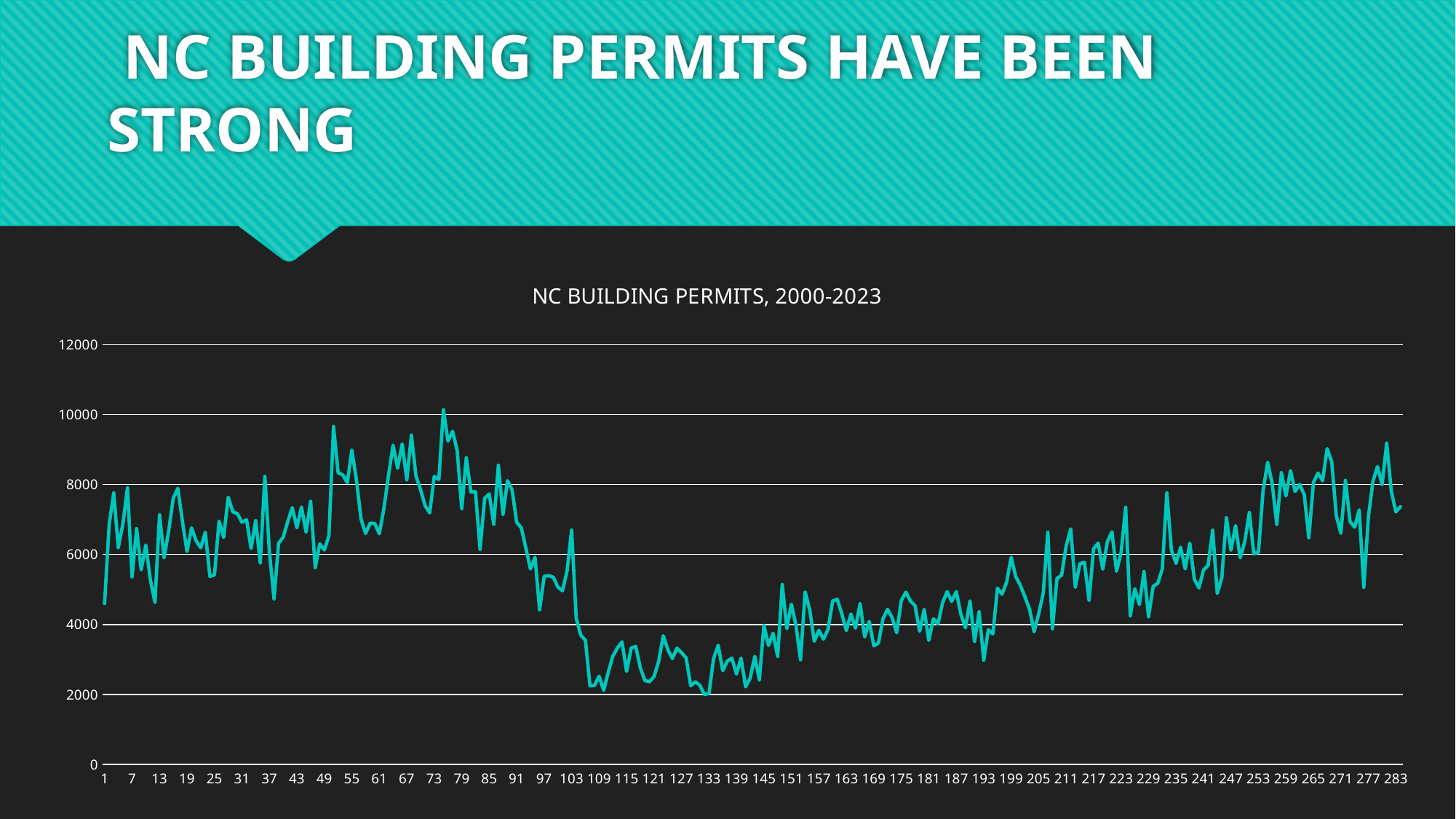
What is the highest value shown on the vertical axis of the chart? 12000 What is the title of the chart? NC BUILDING PERMITS, 2000-2023 What kind of chart is shown on the slide? line chart Is the value at point 163 greater or less than 6000? less Is the value at point 121 greater or less than 4000? less Is the value at point 283 greater or less than 6000? greater Does the line generally rise or fall between point 103 and point 109? fall How many data series are plotted in the chart? 1 Does the line generally rise or fall between point 145 and point 283? rise